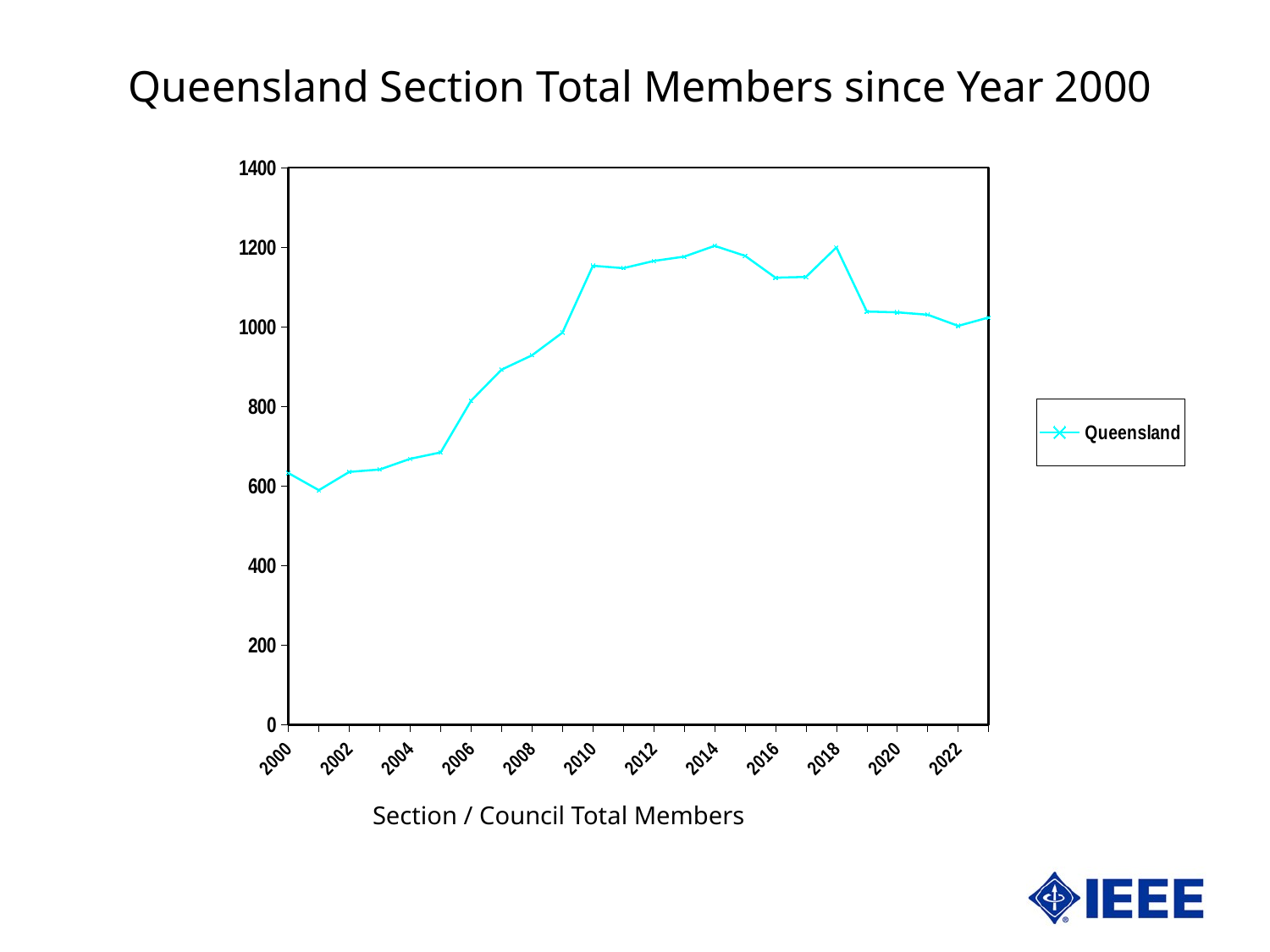
What kind of chart is shown on the slide? line chart Which year has more members, 2018 or 2019? 2018 What is the title of the chart? Queensland Section Total Members since Year 2000 Is the value for 2004 greater or less than 800? less Which year has more members, 2000 or 2010? 2010 Is the value for 2008 greater or less than 1000? less How many series does the legend list? 1 What is the name of the series shown in the legend? Queensland In which year is the number of Queensland members lowest? 2001 Do the values generally rise or fall between 2000 and 2014? rise Is the value for 2010 greater or less than 1000? greater